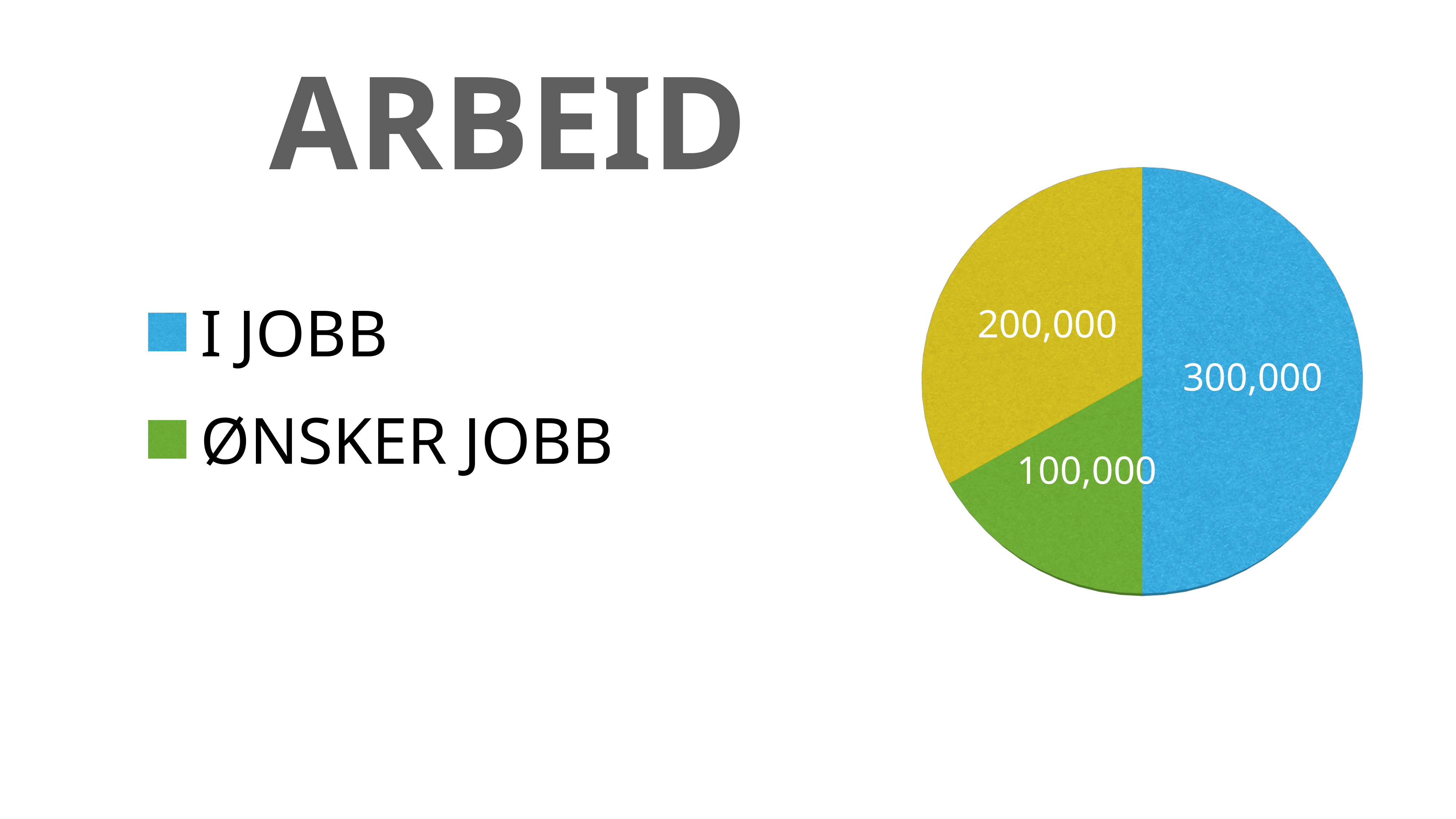
Which is larger, the yellow slice or the ØNSKER JOBB slice? The yellow slice What is the difference between the I JOBB value and the ØNSKER JOBB value? 200,000 Which slice of the pie chart has the smallest value? ØNSKER JOBB What is the total of all three slice values in the pie chart? 600,000 What value is shown on the yellow slice of the pie chart? 200,000 What value is shown for the ØNSKER JOBB slice of the pie chart? 100,000 What share of the pie does the I JOBB slice represent? 50% What value is shown for the I JOBB slice of the pie chart? 300,000 What kind of chart is shown on the slide? Pie chart How many slices does the pie chart have? 3 Which slice of the pie chart has the largest value? I JOBB How many entries does the legend list? 2